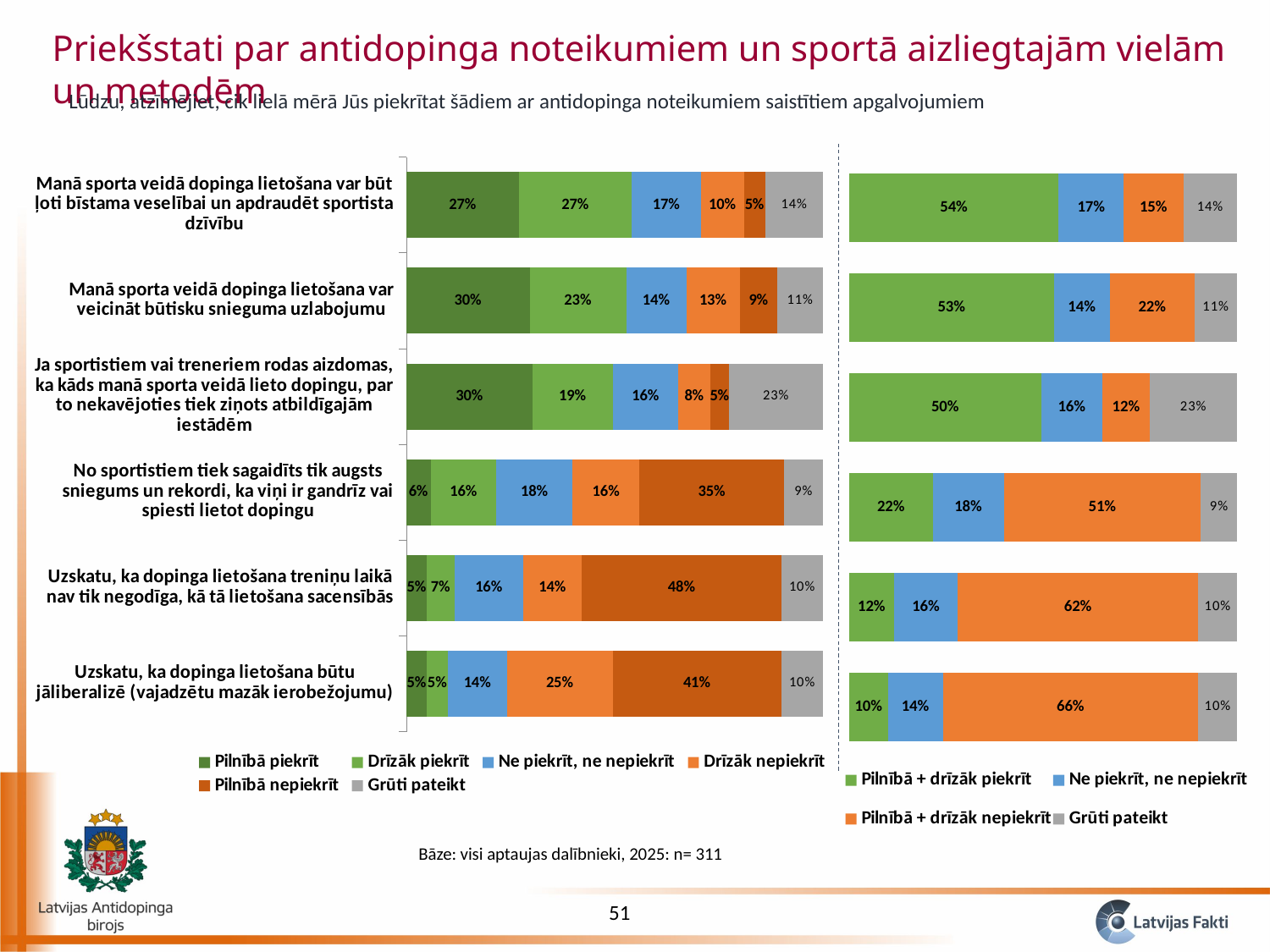
How many series does the legend of the right chart list? 4 In the right chart, which statement has the highest "Pilnībā + drīzāk piekrīt" value? Manā sporta veidā dopinga lietošana var būt ļoti bīstama veselībai un apdraudēt sportista dzīvību In the left chart, which is larger: the "Pilnībā nepiekrīt" value for "No sportistiem tiek sagaidīts tik augsts sniegums..." or for "Uzskatu, ka dopinga lietošana būtu jāliberalizē"? Uzskatu, ka dopinga lietošana būtu jāliberalizē In the right chart, what is the "Pilnībā + drīzāk nepiekrīt" value for "Uzskatu, ka dopinga lietošana būtu jāliberalizē (vajadzētu mazāk ierobežojumu)"? 66% In the right chart, what is the difference between the "Pilnībā + drīzāk nepiekrīt" values for "Uzskatu, ka dopinga lietošana būtu jāliberalizē" and "No sportistiem tiek sagaidīts tik augsts sniegums un rekordi, ka viņi ir gandrīz vai spiesti lietot dopingu"? 15% In the left chart, what is the "Pilnībā nepiekrīt" value for "Uzskatu, ka dopinga lietošana treniņu laikā nav tik negodīga, kā tā lietošana sacensībās"? 48% What type of chart is the right chart? Stacked bar chart In the left chart, what percentage of respondents chose "Pilnībā piekrīt" for the statement "Manā sporta veidā dopinga lietošana var veicināt būtisku snieguma uzlabojumu"? 30% How many statements (categories) are shown in the left chart? 6 In the left chart, which statement has the highest "Grūti pateikt" value? Ja sportistiem vai treneriem rodas aizdomas, ka kāds manā sporta veidā lieto dopingu, par to nekavējoties tiek ziņots atbildīgajām iestādēm In the right chart, which statement has the lowest "Pilnībā + drīzāk piekrīt" value? Uzskatu, ka dopinga lietošana būtu jāliberalizē (vajadzētu mazāk ierobežojumu) How many series does the legend of the left chart list? 6